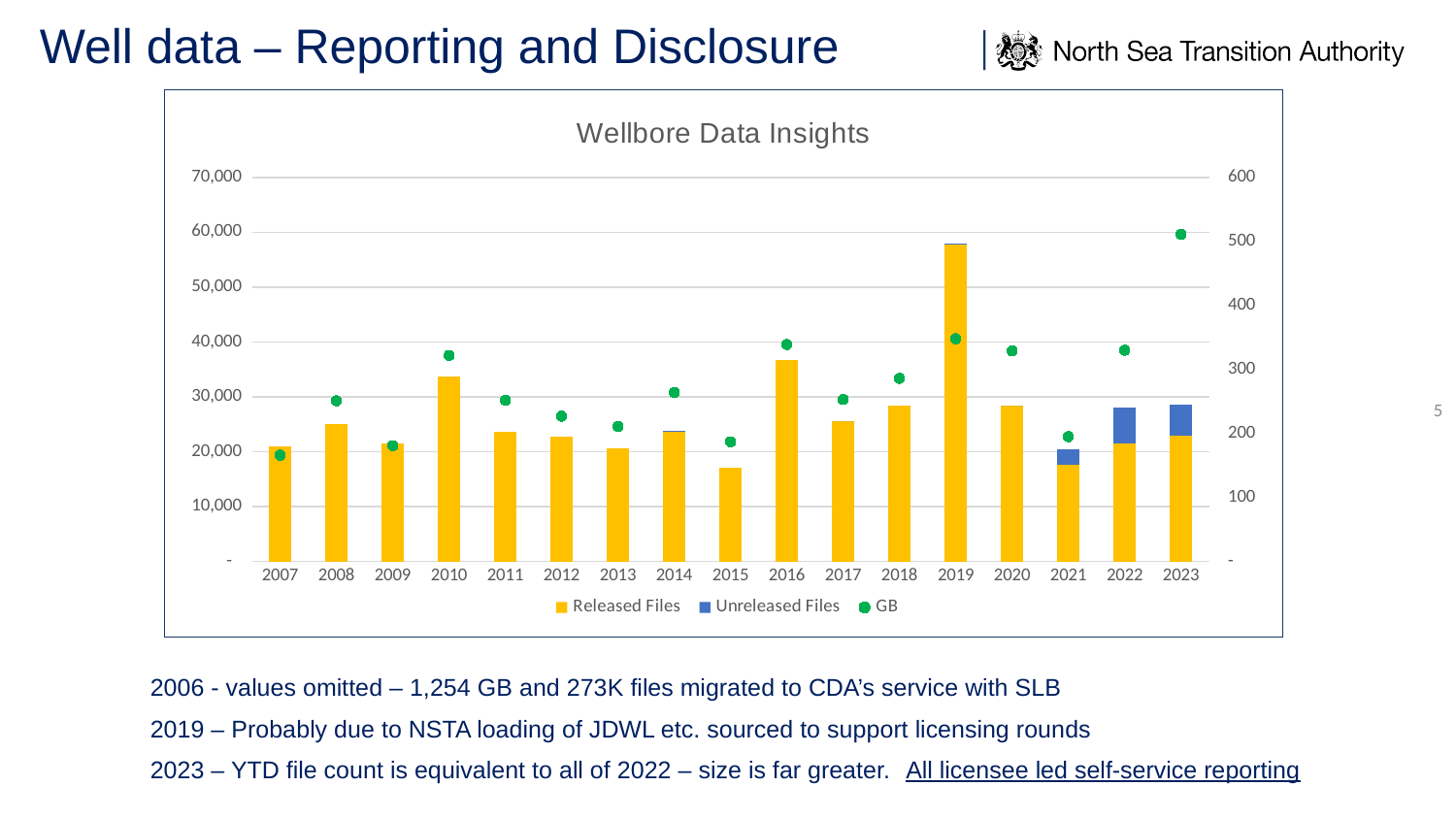
Which year has the highest value for Released Files? 2019 Is the Released Files value for 2019 greater or less than 50,000? greater How many series does the chart legend list? 3 Is the GB value for 2007 greater or less than 200? less Which year has the larger Released Files value, 2016 or 2017? 2016 What is the title of the chart? Wellbore Data Insights Which year has the highest GB value? 2023 Which series is shown in blue in the chart legend? Unreleased Files Is the Released Files value for 2015 greater or less than 20,000? less How many years are shown on the x axis of the chart? 17 What kind of chart is used to show the Released Files and Unreleased Files series? bar chart